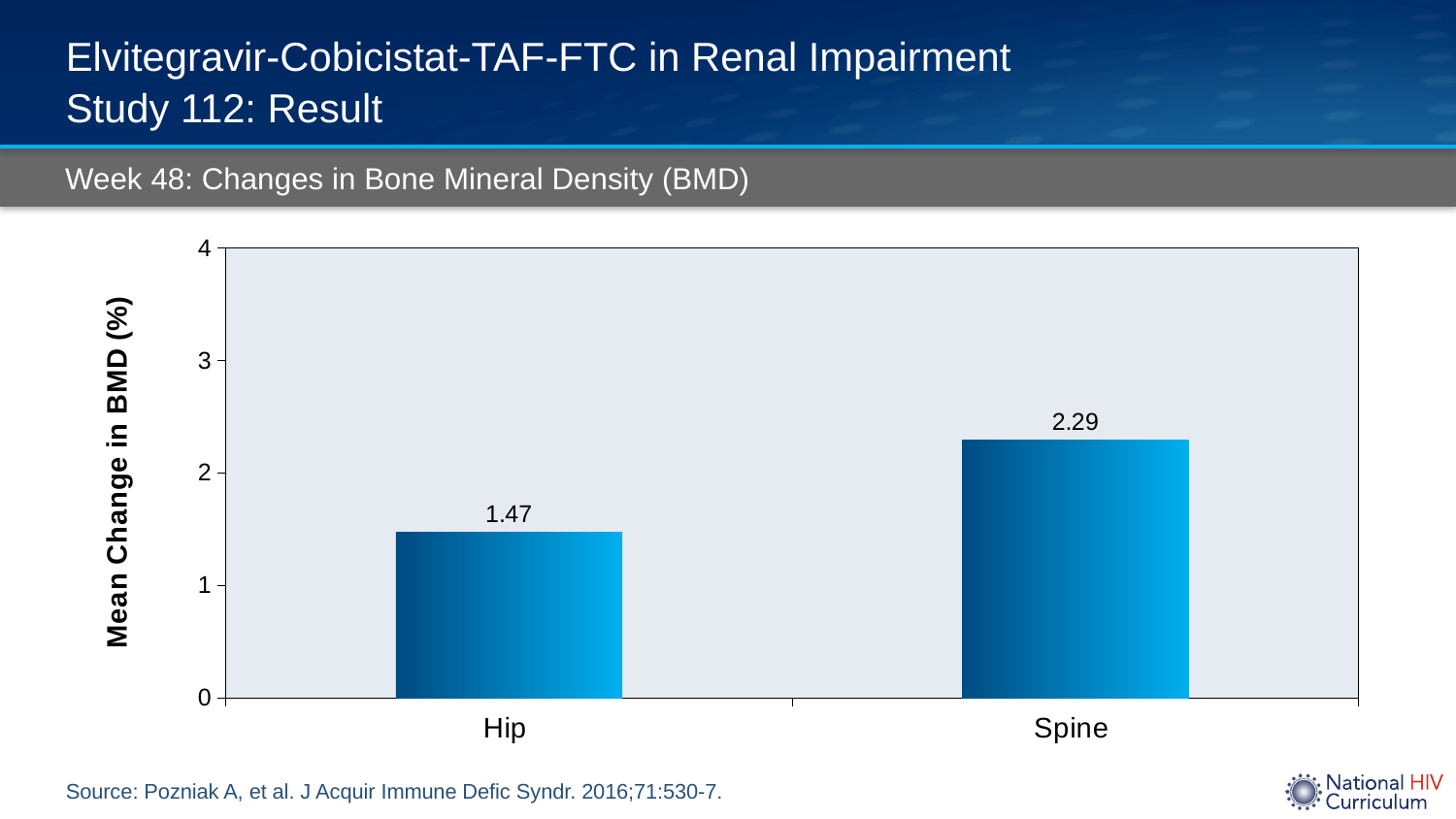
Which category has the lowest mean change in BMD? Hip What is the difference between the mean change in BMD for Spine and Hip? 0.82 What kind of chart is shown on the slide? bar chart Which has a larger mean change in BMD, Hip or Spine? Spine What is the mean change in BMD for Spine? 2.29 Which category has the highest mean change in BMD? Spine How many categories are shown on the x axis? 2 Is the value for Spine greater or less than 2? greater Is the value for Hip greater or less than 2? less What is the mean change in BMD for Hip? 1.47 What is the label of the y axis? Mean Change in BMD (%) What is the maximum value shown on the y axis? 4